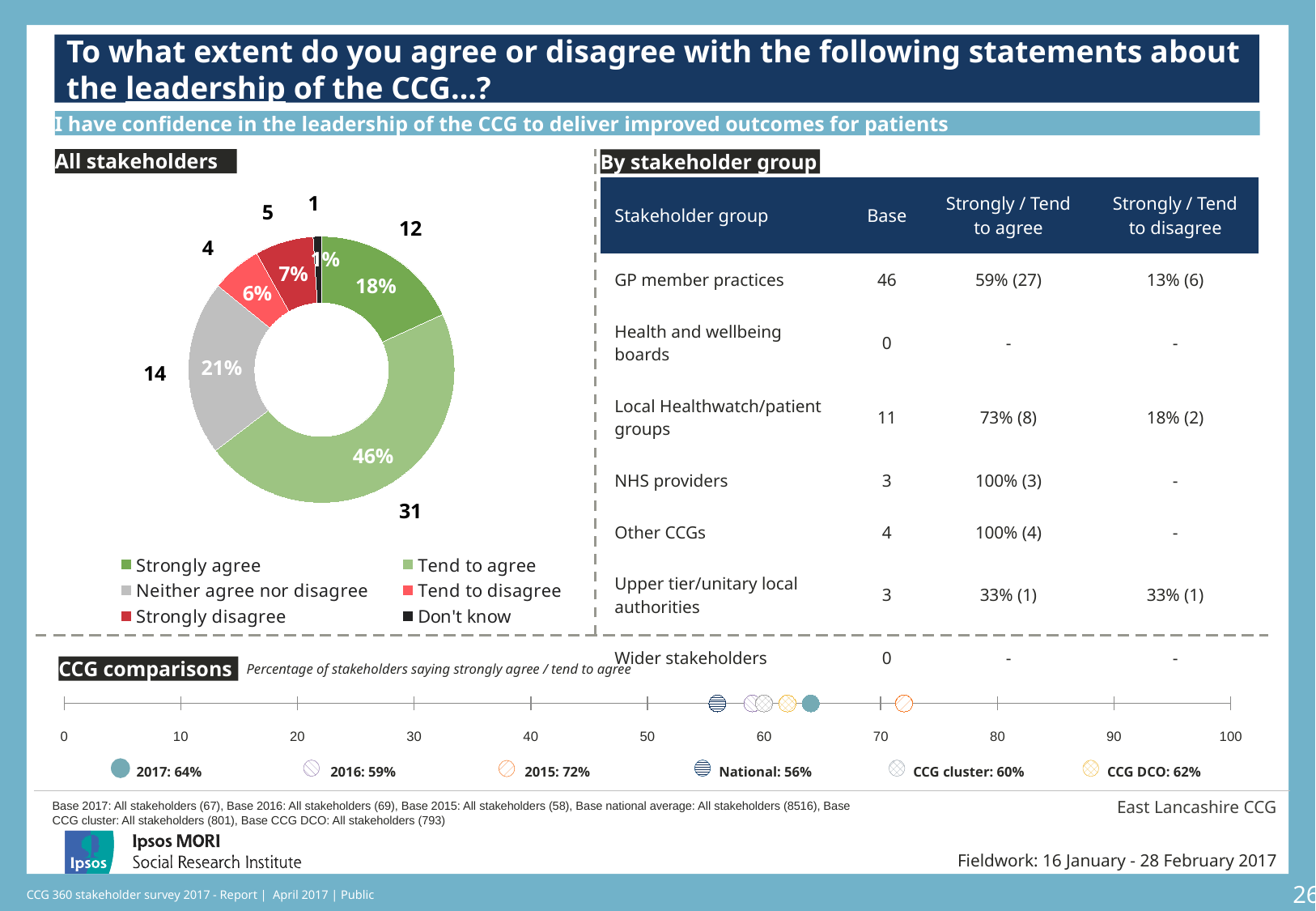
What type of chart is used for the All stakeholders section? Donut chart In the All stakeholders donut chart, what percentage of stakeholders said 'Strongly agree'? 18% In the All stakeholders donut chart, which is larger: 'Tend to disagree' or 'Strongly disagree'? Strongly disagree In the All stakeholders donut chart, what percentage of stakeholders said 'Tend to agree'? 46% In the CCG comparisons chart, which comparator has the highest percentage? 2015: 72% In the CCG comparisons chart, what is the difference between the 2017 value and the National value? 8 In the All stakeholders donut chart, what is the difference in percentage points between 'Tend to agree' and 'Strongly agree'? 28 How many response categories does the legend of the All stakeholders donut chart list? 6 In the All stakeholders donut chart, which response category has the largest share? Tend to agree In the All stakeholders donut chart, which response category has the smallest share? Don't know In the CCG comparisons chart, what is the 2017 percentage of stakeholders saying strongly agree / tend to agree? 64% In the All stakeholders donut chart, how many stakeholders said 'Neither agree nor disagree'? 14